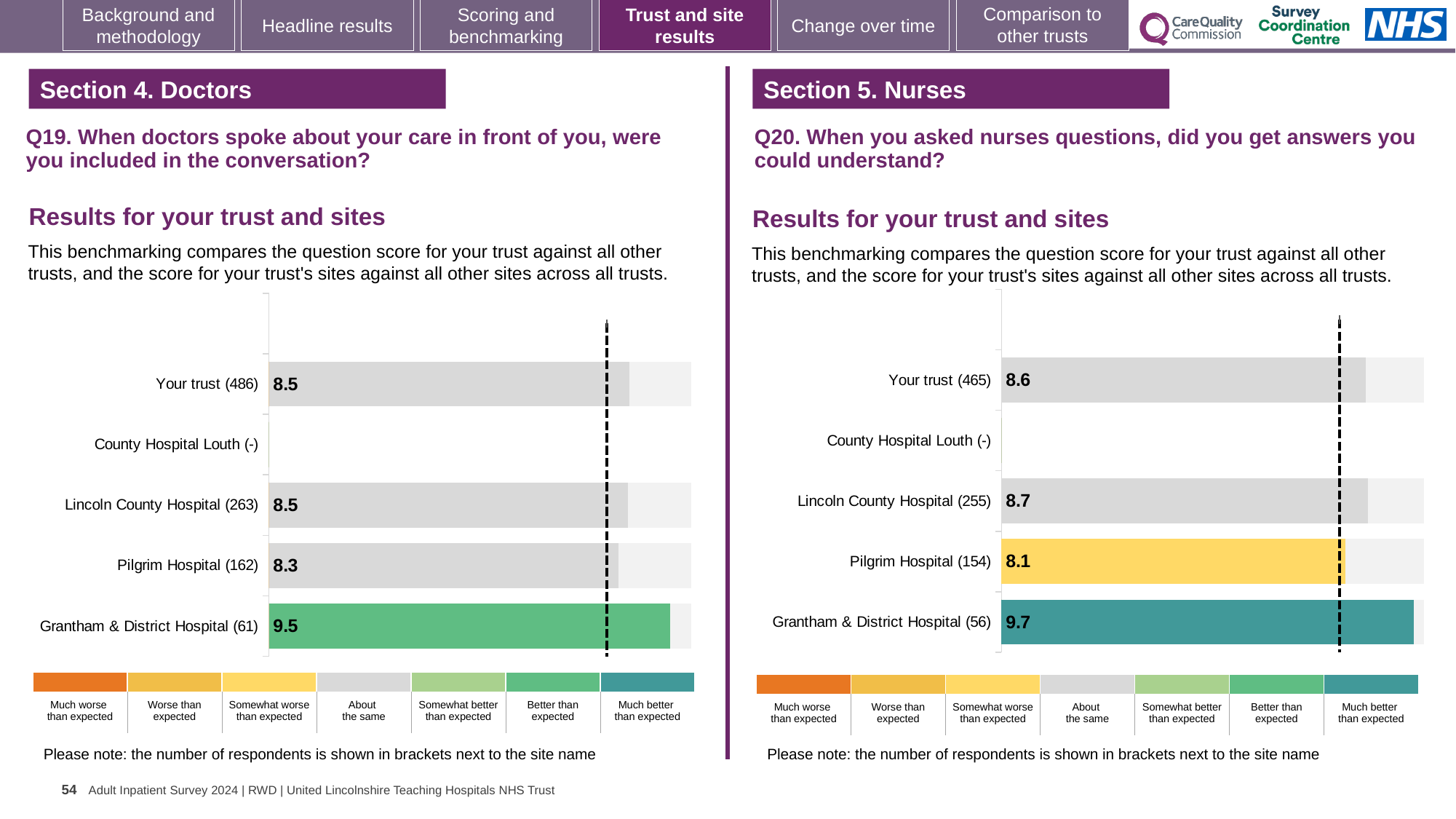
On the Q19 chart (left), what is the difference between the scores for Grantham & District Hospital and Pilgrim Hospital? 1.2 On the Q20 chart (right), which site has the lowest score among those with a plotted bar? Pilgrim Hospital On the Q19 chart (left), what is the score for Grantham & District Hospital? 9.5 On the Q20 chart (right), what is the difference between the scores for Grantham & District Hospital and Your trust? 1.1 On the Q19 chart (left), how many respondents are shown for Your trust? 486 What kind of chart is used on the Q19 chart (left)? Bar chart On the Q20 chart (right), what is the score for Your trust? 8.6 On the Q20 chart (right), what is the score for Lincoln County Hospital? 8.7 On the Q20 chart (right), which is larger, the score for Grantham & District Hospital or the score for Pilgrim Hospital? Grantham & District Hospital On the Q19 chart (left), what is the score for Pilgrim Hospital? 8.3 On the Q20 chart (right), how many categories are listed on the vertical axis? 5 On the Q19 chart (left), which site has the highest score? Grantham & District Hospital